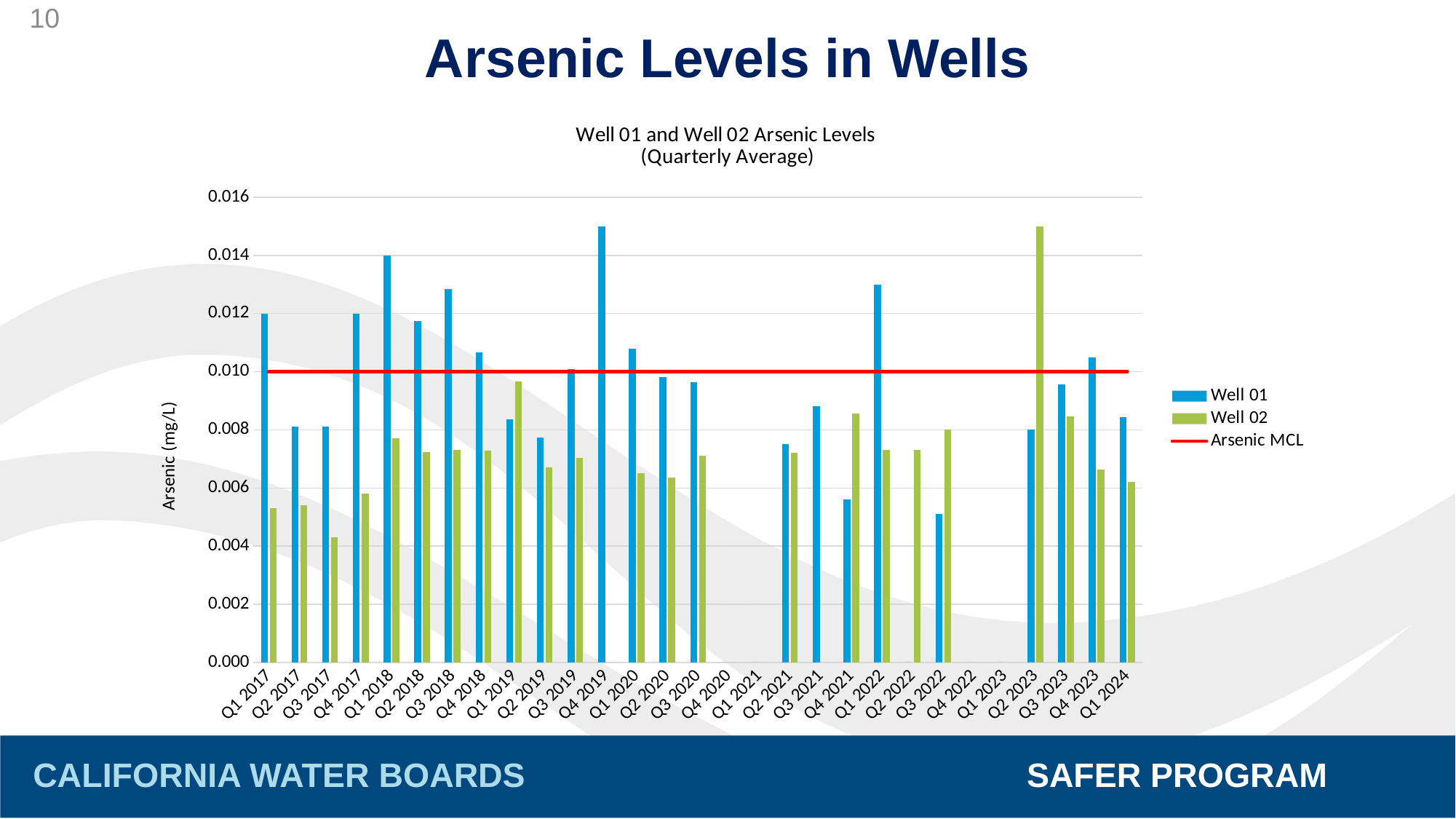
In which quarter does Well 02 reach its highest arsenic level? Q2 2023 How many series does the legend list? 3 What is the label of the vertical axis? Arsenic (mg/L) How many quarters are listed along the x axis? 29 At what value is the Arsenic MCL line drawn? 0.010 What kind of chart is shown on the slide? Combination bar and line chart Is the Well 01 value for Q4 2019 greater or less than 0.014? greater In which quarter does Well 02 have its lowest arsenic level? Q3 2017 Is the Well 02 value for Q3 2017 greater or less than 0.006? less In which quarter does Well 01 reach its highest arsenic level? Q4 2019 What is the title of the chart? Well 01 and Well 02 Arsenic Levels (Quarterly Average) In Q2 2023, which well has the higher arsenic level, Well 01 or Well 02? Well 02